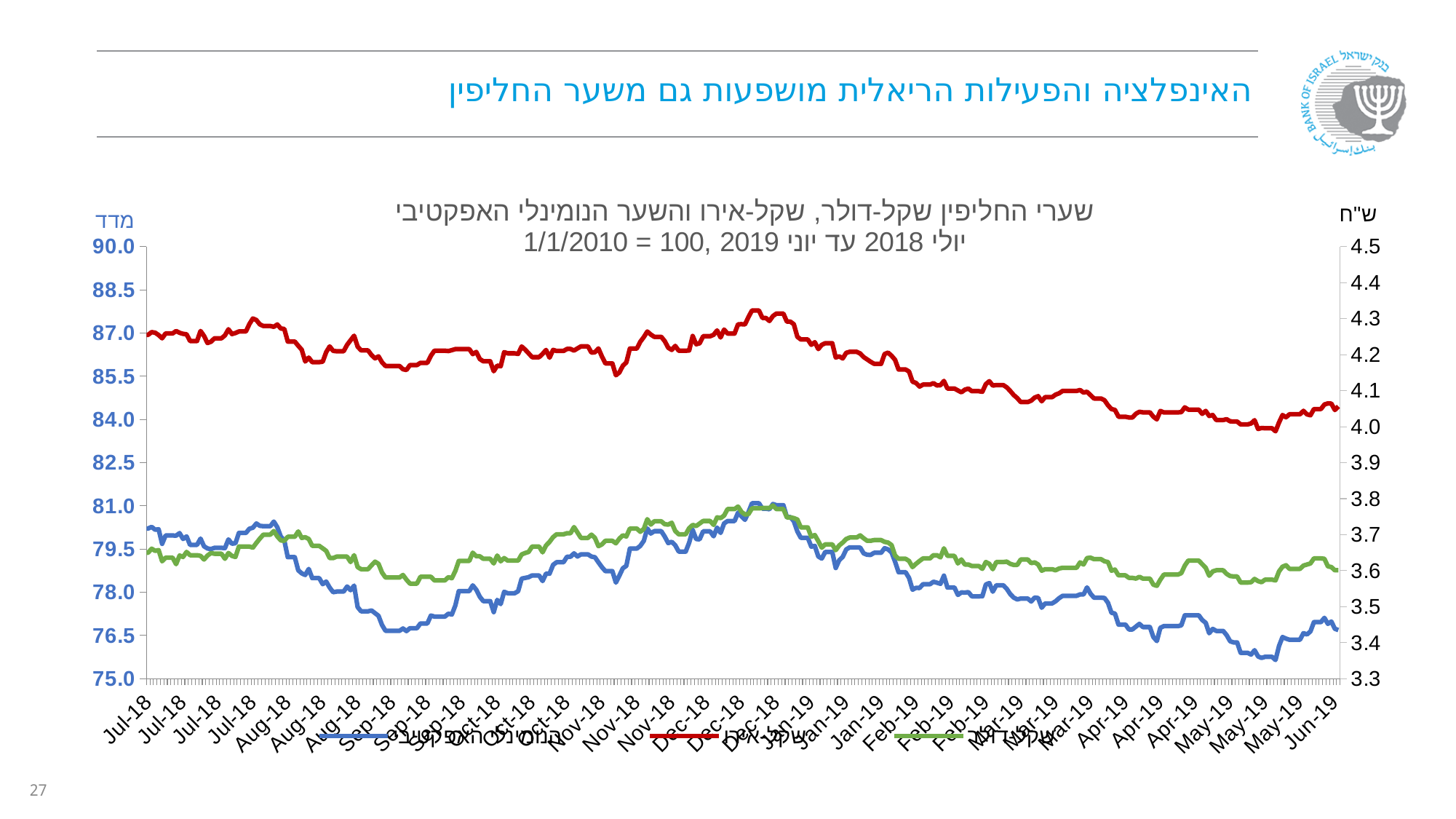
Is the value of the red line at its peak around Dec-18 greater or less than 4.2 on the right axis? greater What kind of chart is shown on the slide? line chart Which line is higher on the right axis throughout the period, the red line or the green line? red line What base value does the chart title state for the index (1/1/2010 = ?) 100 Does the red line rise or fall overall from Jul-18 to Jun-19? fall Is the value of the blue line at its lowest point around May-19 greater or less than 76.5 on the left axis? less Does the blue line rise or fall overall from Jul-18 to Jun-19? fall Is the value of the blue line at Jul-18 greater or less than 78.0 on the left axis? greater How many series are plotted in the chart? 3 What is the label of the left vertical axis? מדד